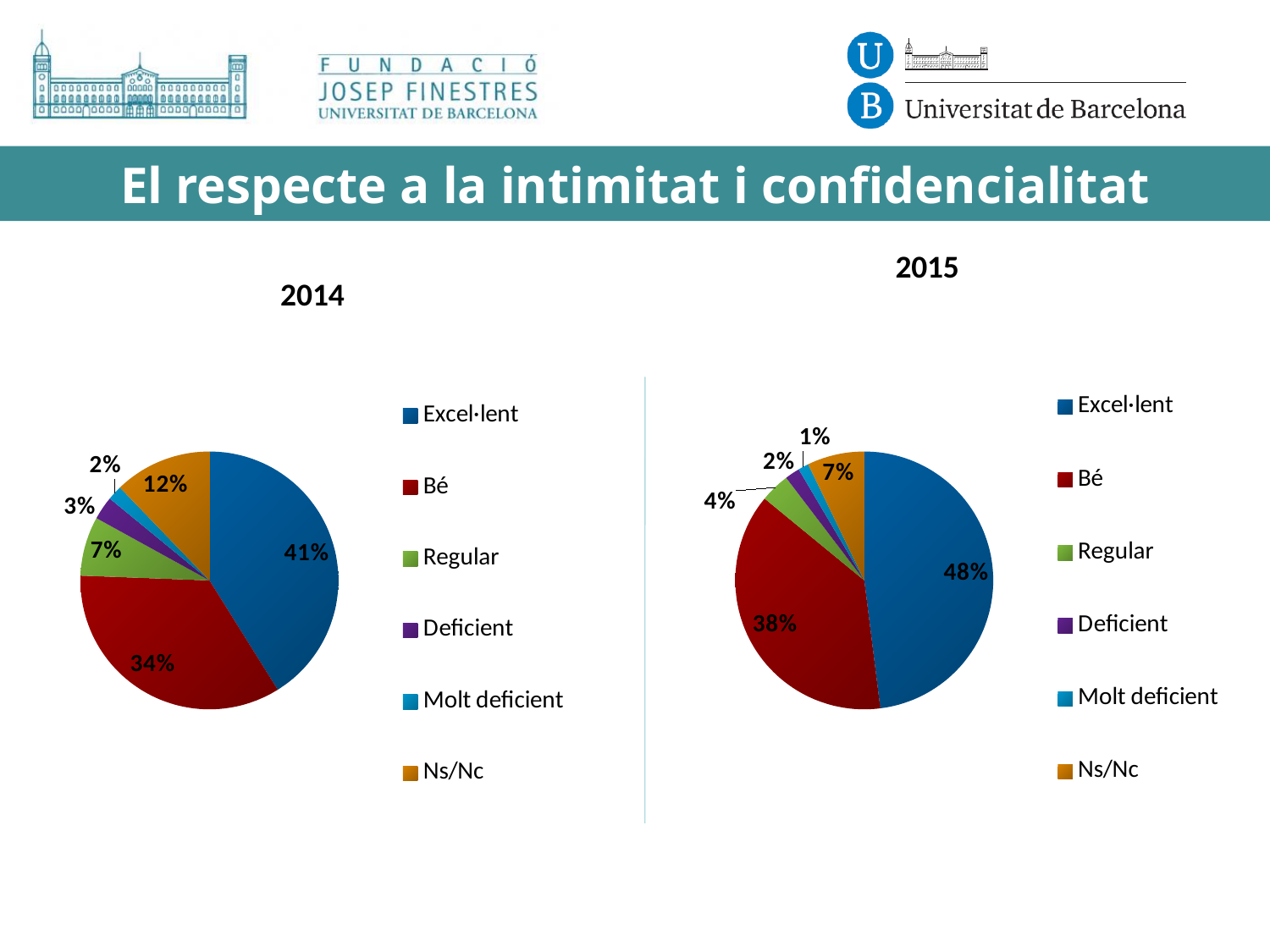
In the 2014 chart, which category has the smallest slice? Molt deficient In the 2015 chart, what is the value for Regular? 4% In the 2014 chart, what is the value for Ns/Nc? 12% What kind of chart is the 2015 chart? Pie chart In the 2015 chart, which category has the largest slice? Excel·lent In the 2014 chart, what is the difference between the Excel·lent and Bé slices? 7% What colour is the Deficient slice in the 2014 chart? Purple Which is larger in the 2015 chart: Ns/Nc or Regular? Ns/Nc How many categories does the legend of the 2014 chart list? 6 In the 2015 chart, which category has the smallest slice? Molt deficient In the 2015 chart, what share of the pie is Bé? 38% In the 2014 chart, what share of the pie is Excel·lent? 41%